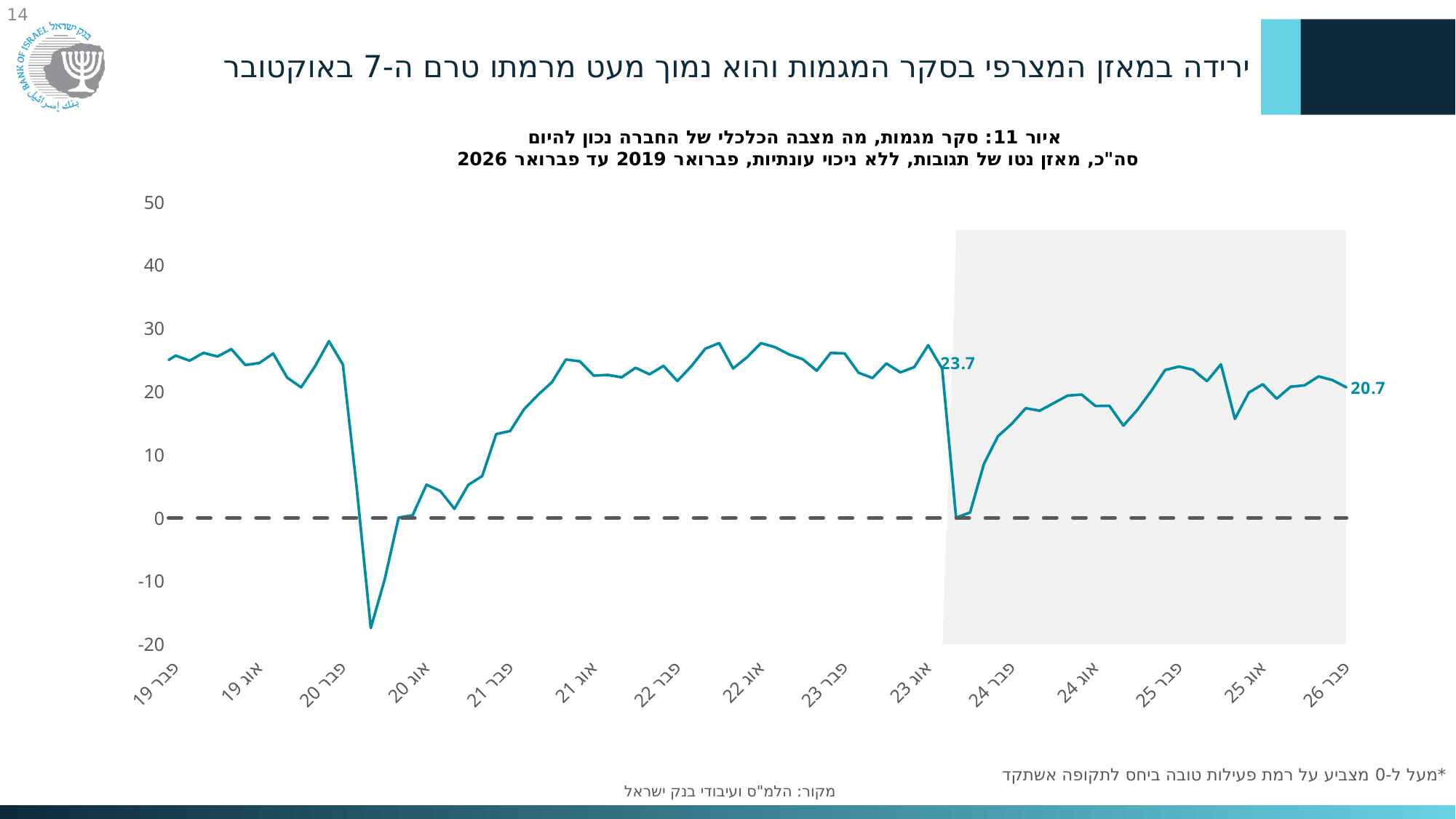
Does the line generally rise or fall from the late-2023 low to פבר 26? rise Which labelled value is larger: the one before the late-2023 drop or the one at פבר 26? 23.7 (before the late-2023 drop) What type of chart is shown on the slide? line chart What is the highest value shown on the y axis? 50 At what y-axis value is the horizontal dashed line drawn? 0 How many date labels are shown on the x axis? 15 Is the value of the line at פבר 20 greater or less than 20? greater Is the value of the line at אוג 24 greater or less than 10? greater What is the labelled value of the line just before the sharp drop in late 2023? 23.7 Is the lowest point of the line, in 2020, greater or less than -10? less What is the labelled value at the end of the line (פבר 26)? 20.7 What is the difference between the labelled value 23.7 and the final labelled value 20.7? 3.0